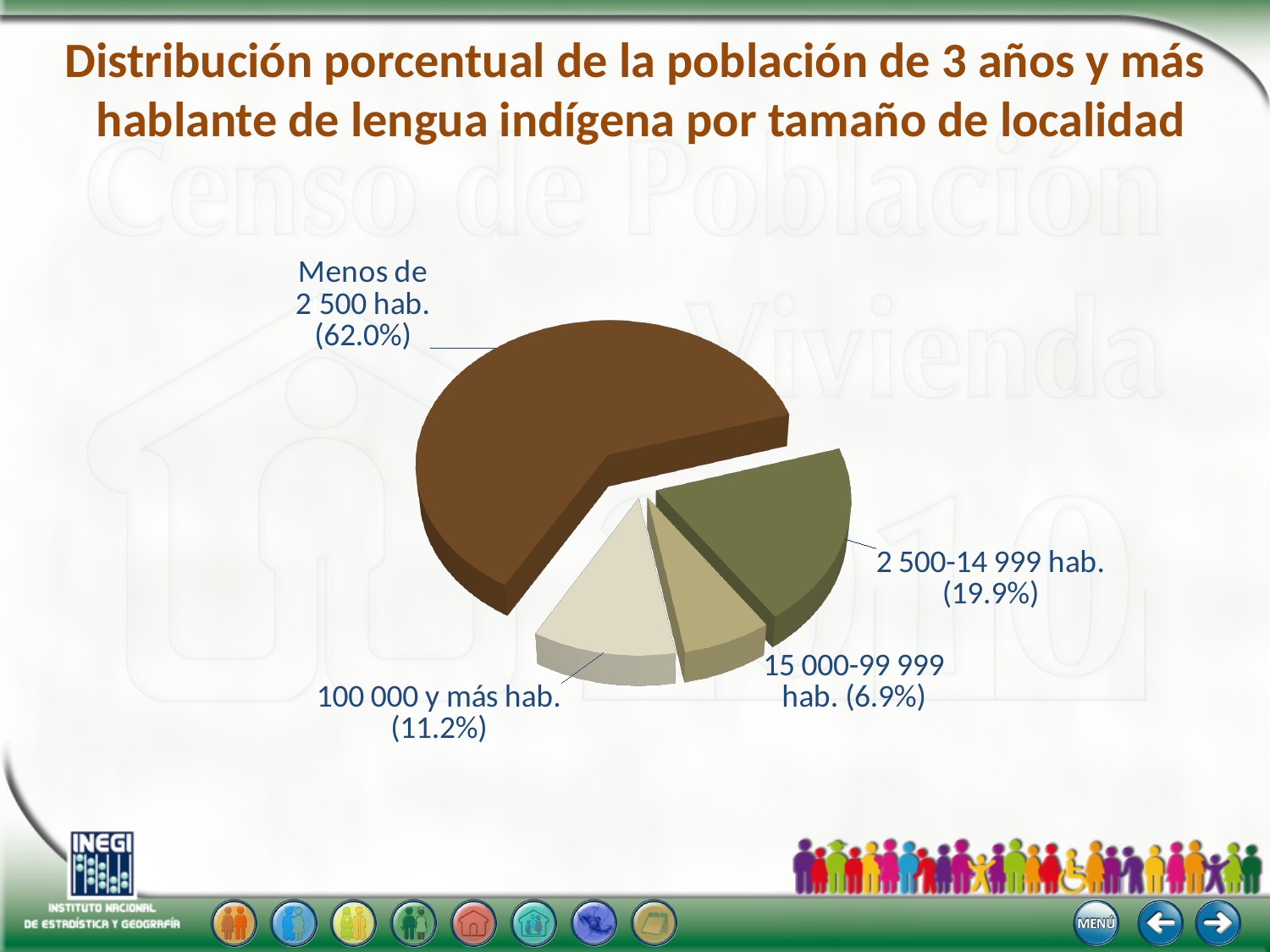
What is the combined share of the '2 500-14 999 hab.' and '15 000-99 999 hab.' slices? 26.8% What is the title of the chart on the slide? Distribución porcentual de la población de 3 años y más hablante de lengua indígena por tamaño de localidad What percentage of the population is shown for 'Menos de 2 500 hab.'? 62.0% What percentage is shown for the '100 000 y más hab.' slice? 11.2% What percentage is shown for the '2 500-14 999 hab.' slice? 19.9% What is the difference in percentage points between 'Menos de 2 500 hab.' and '2 500-14 999 hab.'? 42.1 How many slices does the pie chart have? 4 Which locality size category has the largest share of the pie? Menos de 2 500 hab. Which is larger: the share for '100 000 y más hab.' or for '15 000-99 999 hab.'? 100 000 y más hab. Which locality size category has the smallest share of the pie? 15 000-99 999 hab. What kind of chart is shown on the slide? Pie chart What percentage is shown for the '15 000-99 999 hab.' slice? 6.9%